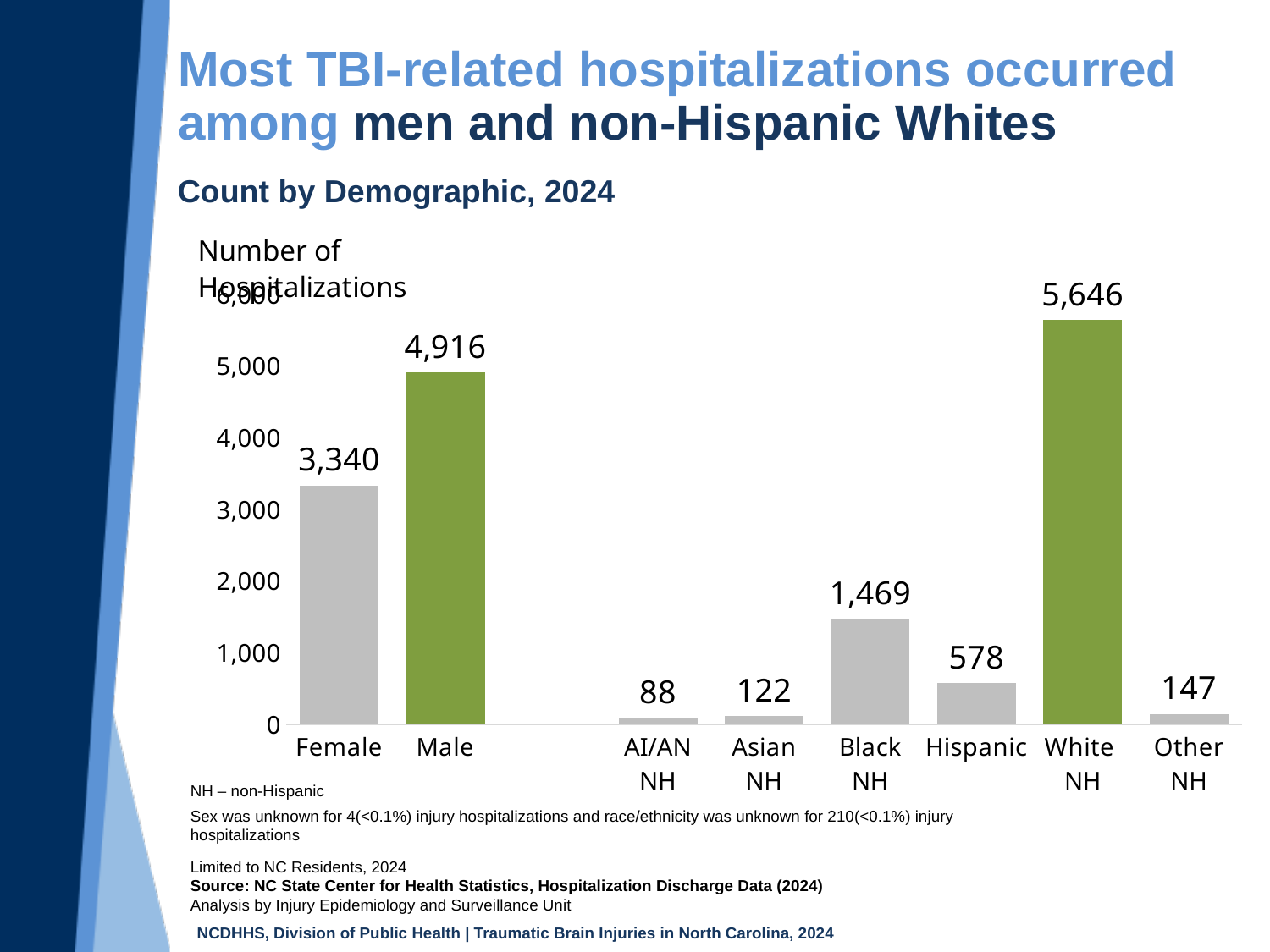
What is the number of hospitalizations for Male? 4,916 What is the number of hospitalizations for Hispanic? 578 What is the number of hospitalizations for Black NH? 1,469 How many categories are shown on the chart? 8 What kind of chart is shown on the slide? Bar chart What is the difference in hospitalizations between White NH and Black NH? 4,177 What is the number of hospitalizations for Female? 3,340 Which category has the highest number of hospitalizations? White NH Which has more hospitalizations, Asian NH or Other NH? Other NH What is the difference in hospitalizations between Male and Female? 1,576 What is the title of the chart? Count by Demographic, 2024 Which category has the lowest number of hospitalizations? AI/AN NH